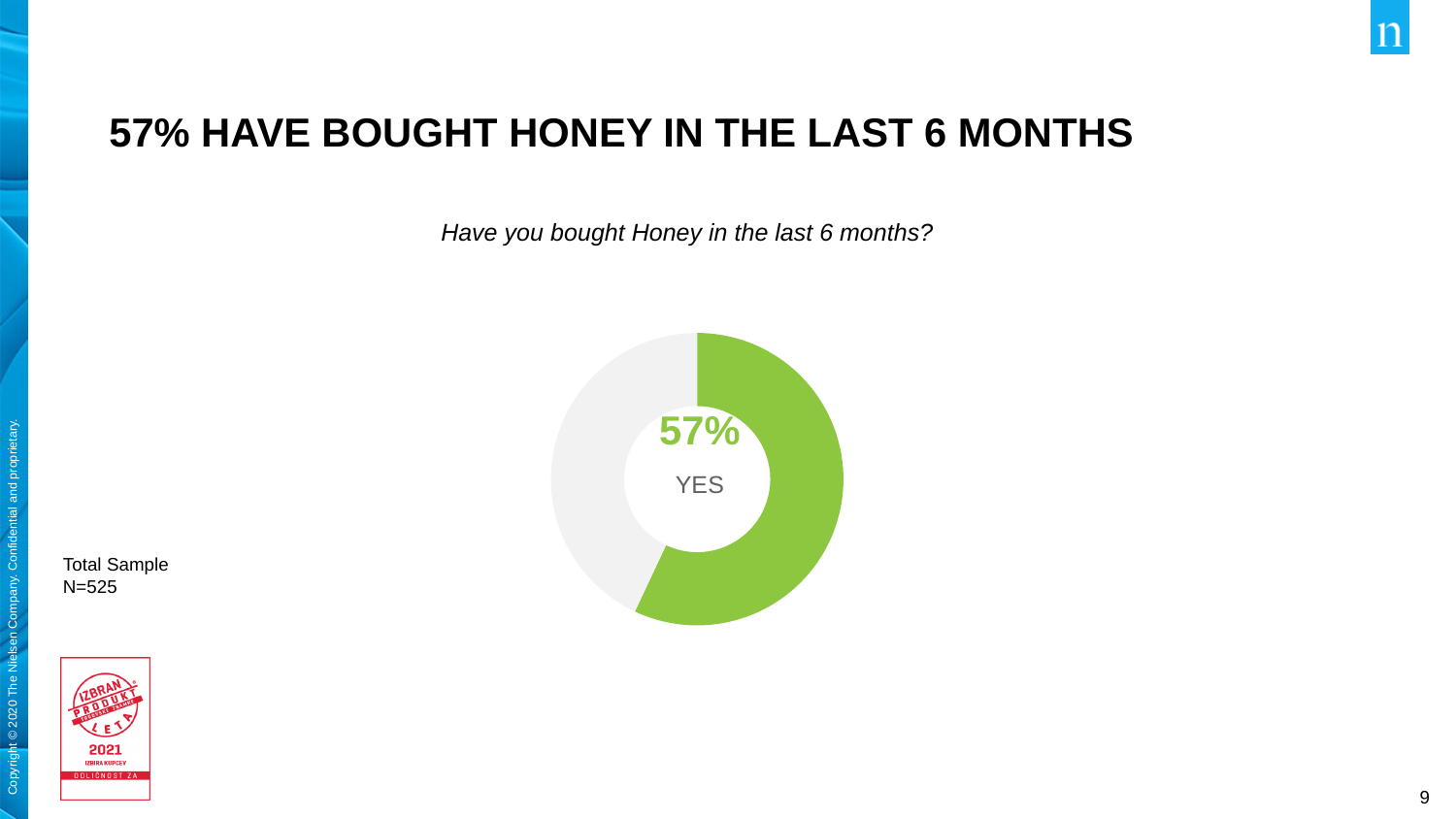
What percentage of respondents answered YES to having bought honey in the last 6 months? 57% How many slices does the chart have? 2 What kind of chart is shown on the slide? doughnut chart Which slice of the chart is larger, the green YES slice or the grey slice? the green YES slice What colour is the YES slice of the chart? green What question is the chart answering, as written above it? Have you bought Honey in the last 6 months? Does the YES slice cover more or less than half of the chart? more